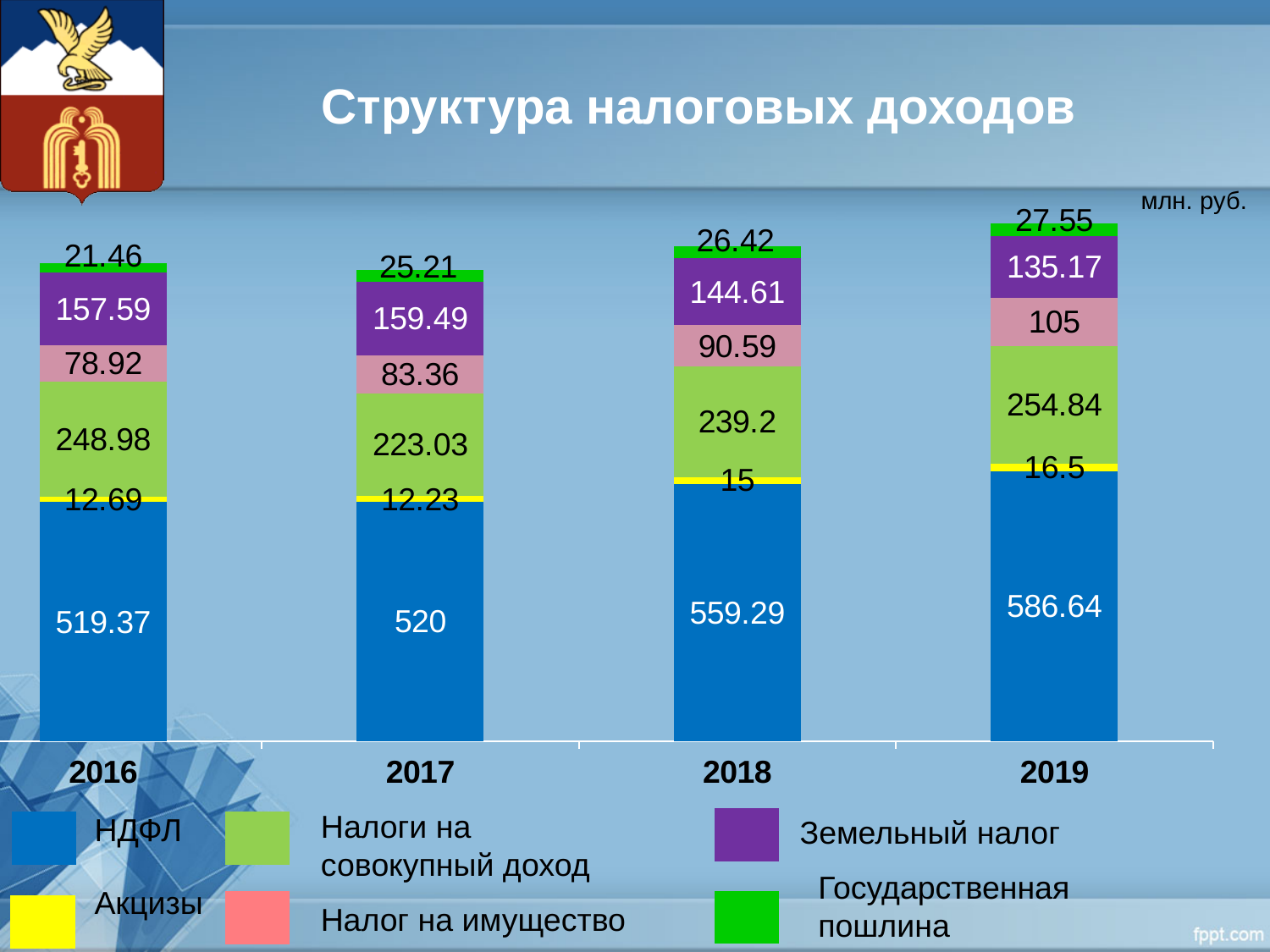
How many series does the legend list? 6 In which year is the НДФЛ value the highest? 2019 How many years are shown on the x axis? 4 What is the value of Земельный налог for 2017? 159.49 What is the value of Налог на имущество for 2018? 90.59 What is the value of НДФЛ for 2019? 586.64 In which year is the Налоги на совокупный доход value the lowest? 2017 What kind of chart is shown on the slide? Stacked bar chart What is the difference between the Государственная пошлина values for 2019 and 2016? 6.09 What is the value of Акцизы for 2016? 12.69 Which is larger: Земельный налог in 2016 or in 2019? 2016 What is the total of the stacked bar for 2018? 1075.11